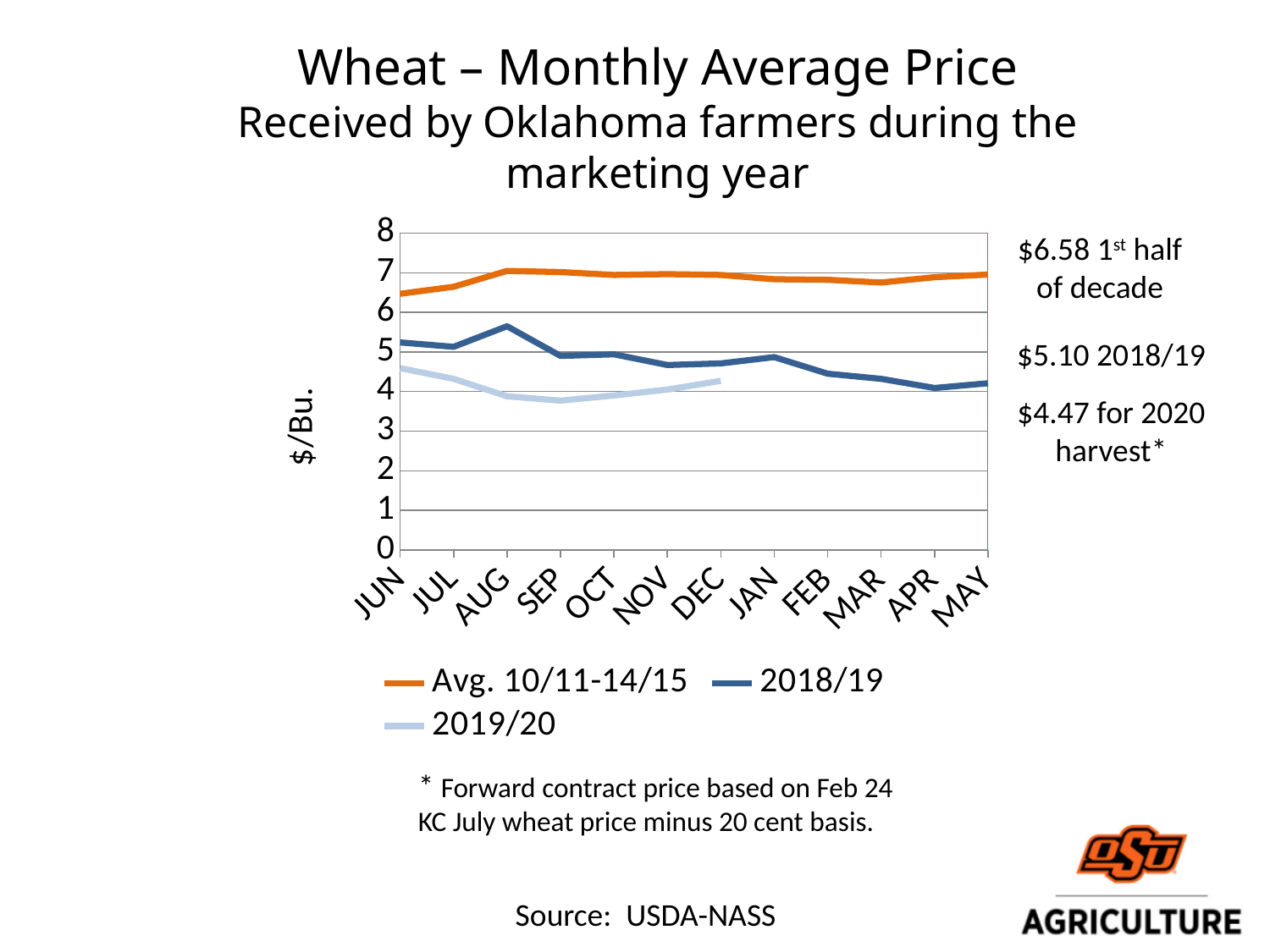
What is the label on the y axis? $/Bu. How many months are shown along the x axis? 12 In AUG, which is larger: the 2018/19 value or the 2019/20 value? 2018/19 Is the value for 2018/19 in DEC greater or less than 5? less In which month does the 2018/19 series reach its highest value? AUG What kind of chart is shown on the slide? Line chart Is the value for Avg. 10/11-14/15 in JUN greater or less than 6? greater Which series has the highest values across the marketing year? Avg. 10/11-14/15 Is the value for 2018/19 in AUG greater or less than 5? greater Does the 2018/19 series rise or fall from JAN to APR? Fall How many series does the legend list? 3